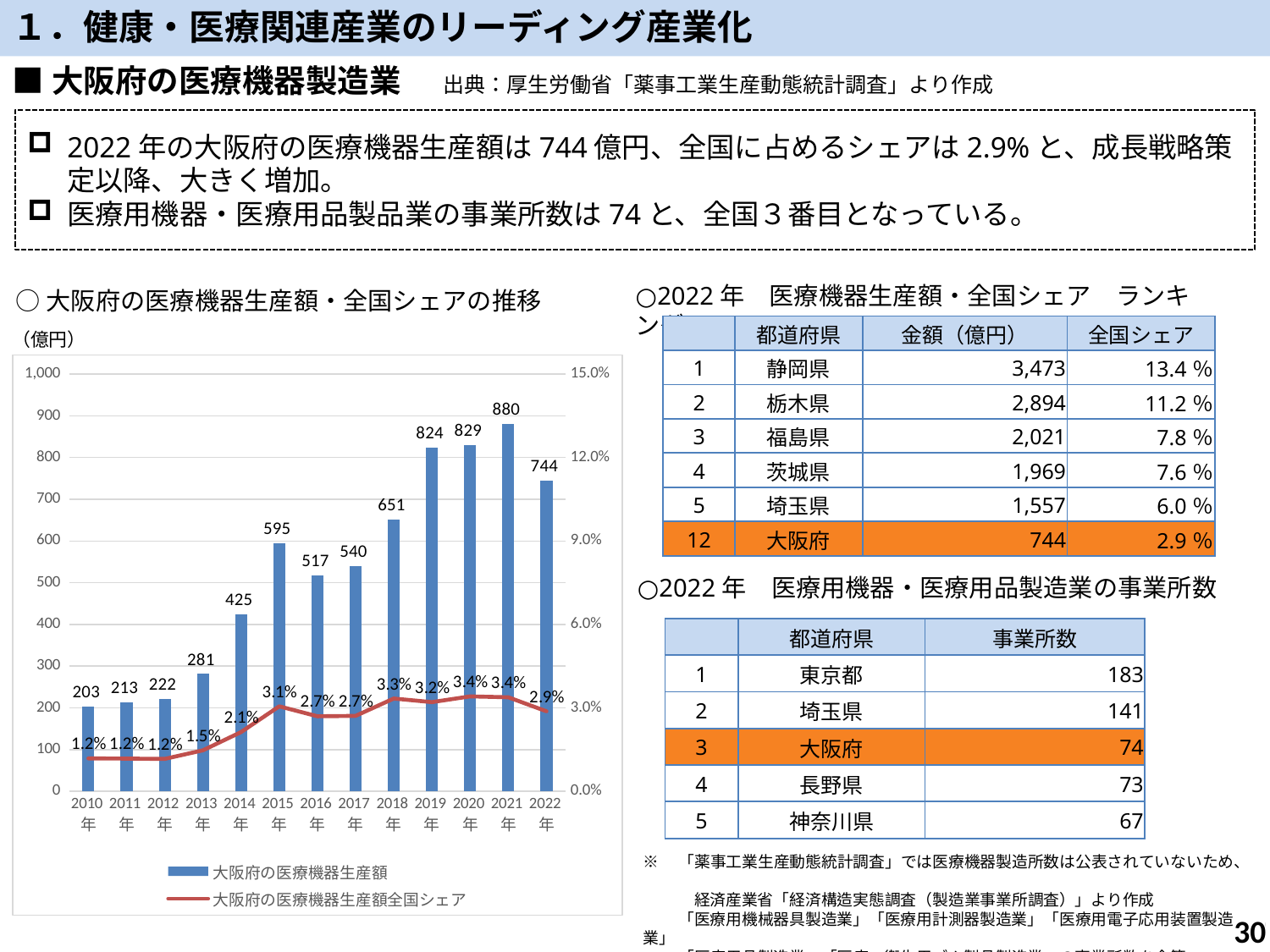
What kind of chart is 大阪府の医療機器生産額・全国シェアの推移? Combined bar and line chart In the chart 大阪府の医療機器生産額・全国シェアの推移, which year has the lowest 大阪府の医療機器生産額? 2010年 In the chart 大阪府の医療機器生産額・全国シェアの推移, which year has the highest 大阪府の医療機器生産額? 2021年 In the chart 大阪府の医療機器生産額・全国シェアの推移, how many series does the legend list? 2 In the chart 大阪府の医療機器生産額・全国シェアの推移, what is the value of 大阪府の医療機器生産額 for 2014年? 425 In the chart 大阪府の医療機器生産額・全国シェアの推移, what is the value of 大阪府の医療機器生産額 for 2021年? 880 In the chart 大阪府の医療機器生産額・全国シェアの推移, what is the 全国シェア value for 2022年? 2.9% In the chart 大阪府の医療機器生産額・全国シェアの推移, how many years are shown on the x axis? 13 In the chart 大阪府の医療機器生産額・全国シェアの推移, what is the difference between the 大阪府の医療機器生産額 values for 2021年 and 2022年? 136 In the chart 大阪府の医療機器生産額・全国シェアの推移, does 大阪府の医療機器生産額 rise or fall from 2010年 to 2015年? Rise In the chart 大阪府の医療機器生産額・全国シェアの推移, what unit is shown above the left axis? 億円 In the chart 大阪府の医療機器生産額・全国シェアの推移, which is larger, the 大阪府の医療機器生産額 for 2016年 or for 2017年? 2017年